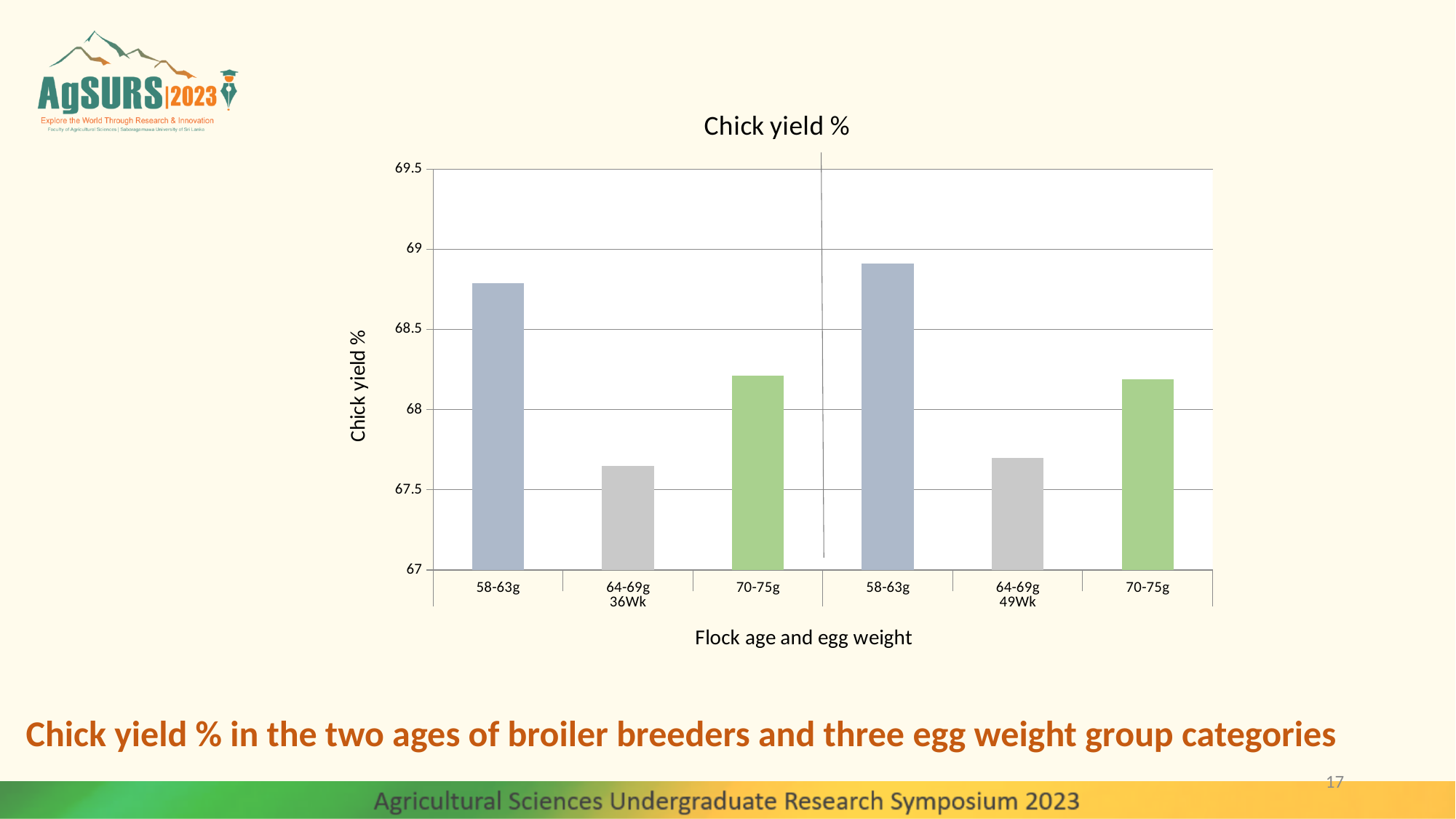
What is the title of the chart? Chick yield % What kind of chart is shown on the slide? bar chart What is the x-axis title of the chart? Flock age and egg weight Within the 49Wk flock age, which egg weight group has the lowest chick yield %? 64-69g Within the 36Wk flock age, which egg weight group has the lowest chick yield %? 64-69g Within the 36Wk flock age, which egg weight group has the highest chick yield %? 58-63g Within the 49Wk flock age, which egg weight group has the highest chick yield %? 58-63g At 49Wk, which has the larger chick yield %: 70-75g or 64-69g? 70-75g How many bars are plotted in the chart? 6 Is the chick yield % for 64-69g at 49Wk greater or less than 68? less Is the chick yield % for 58-63g at 36Wk greater or less than 68.5? greater Is the chick yield % for 70-75g at 36Wk greater or less than 68? greater